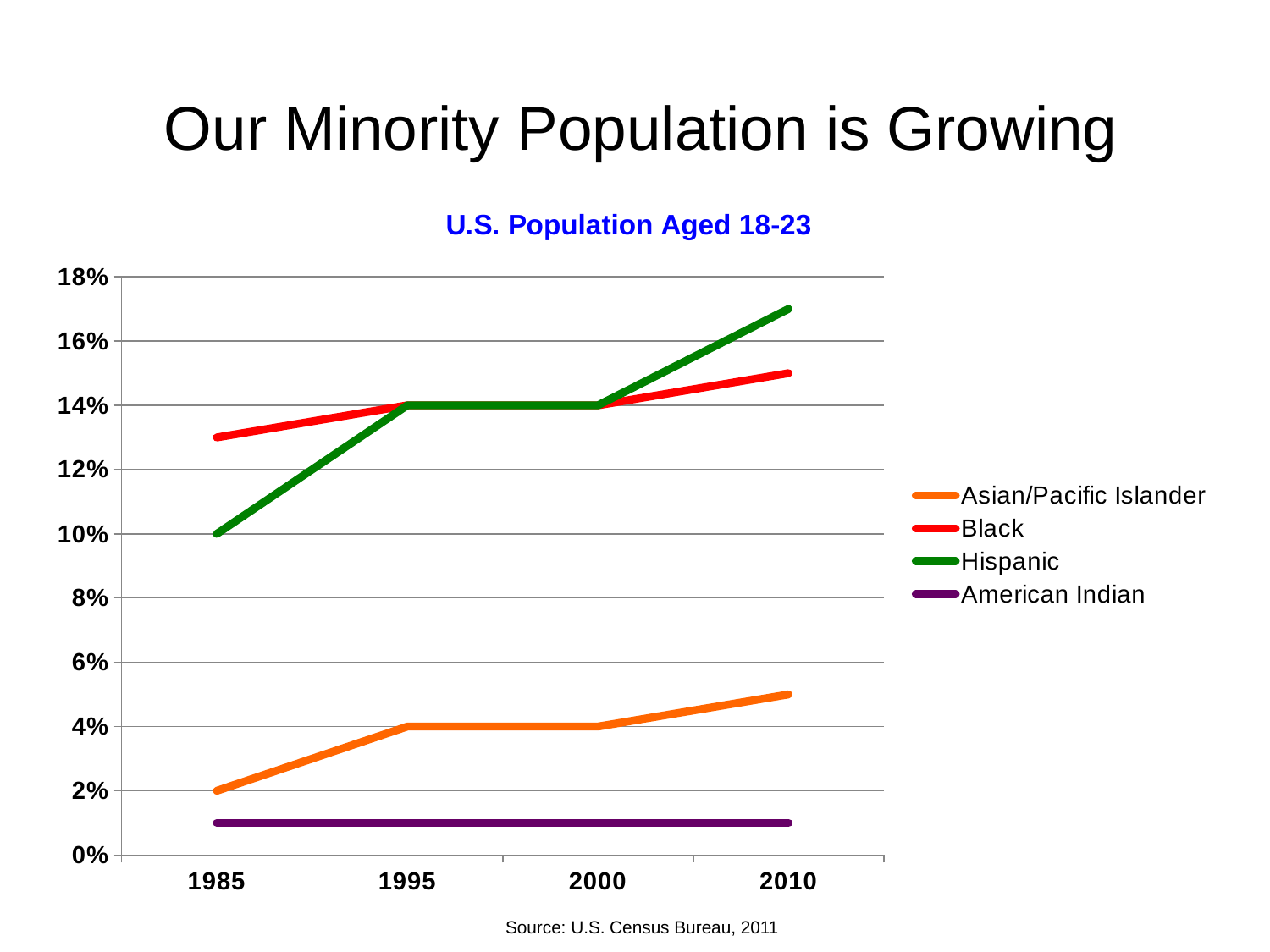
What is the value for Asian/Pacific Islander in 1985? 2% Is the value for Hispanic in 2010 greater or less than 16%? greater What is the value for Hispanic in 1995? 14% What is the value for Hispanic in 1985? 10% Which series has the lowest value in 2010? American Indian What kind of chart is shown on the slide? line chart What is the value for Asian/Pacific Islander in 2000? 4% Does the Hispanic line rise or fall from 1985 to 2010? rise How many years are shown on the x axis? 4 How many series does the legend list? 4 Which series has the highest value in 2010? Hispanic Is the value for Black in 1985 greater or less than 12%? greater